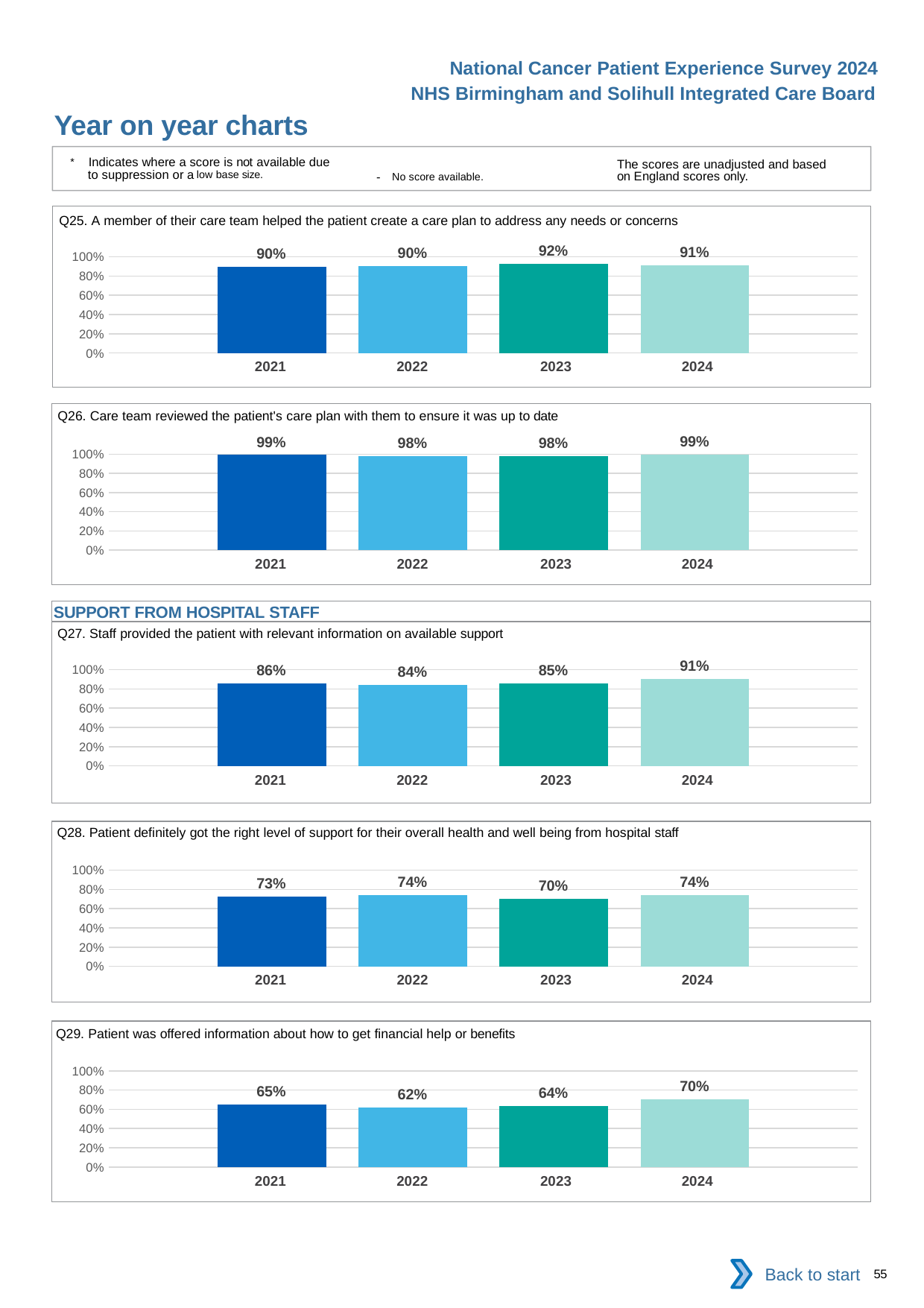
In the Q26 chart, which year has the lowest value? 2022 and 2023 (both 98%) In the Q27 chart, what is the difference between the 2024 value and the 2022 value? 7 percentage points In the Q25 chart, what is the value for 2023? 92% In the Q28 chart, is the value for 2022 larger or smaller than the value for 2023? larger How many charts are shown on the slide? 5 In the Q29 chart, which year has the lowest value? 2022 What kind of chart is used for Q26? bar chart In the Q28 chart, what is the value for 2023? 70% In the Q27 chart, which year has the highest value? 2024 How many years are shown on the x axis of the Q25 chart? 4 In the Q29 chart, is the value for 2024 greater or less than 80%? less In the Q29 chart, what is the difference between the 2024 value and the 2021 value? 5 percentage points